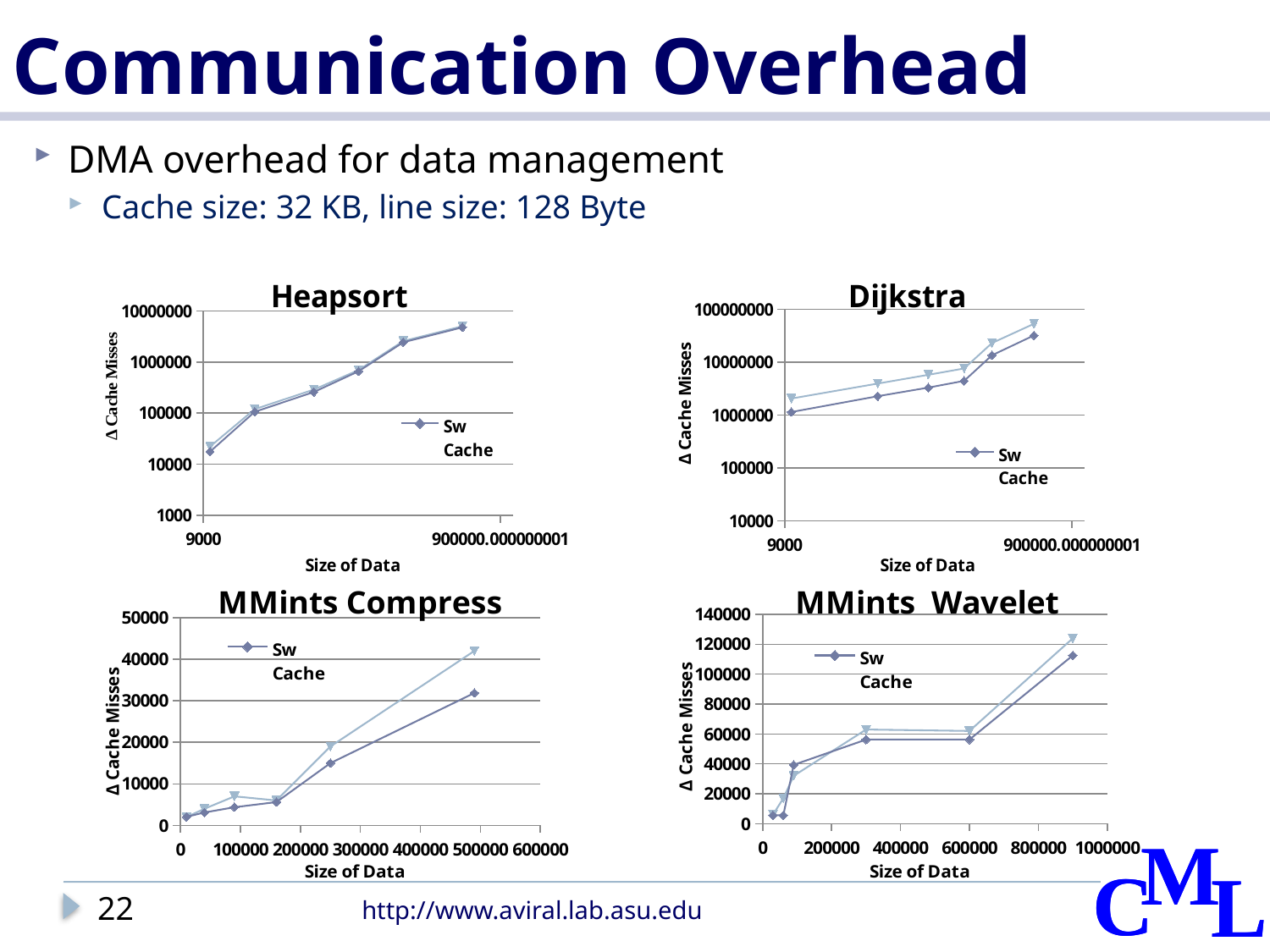
In the Dijkstra chart, is the value for Cache at the largest data size greater or less than 10000000? greater In the Heapsort chart, is the value for Sw at the smallest data size greater or less than 10000? greater In the Heapsort chart, do the cache misses rise or fall as the size of data increases? rise In the Dijkstra chart, do the values for the Cache series rise or fall along the x axis? rise In the MMints Wavelet chart, at the largest data size, which series is higher, Sw or Cache? Cache In the MMints Wavelet chart, is the value for Sw at the largest data size greater or less than 120000? less In the MMints Compress chart, at the largest data size, which series has the higher value, Sw or Cache? Cache What is the x-axis title of the MMints Wavelet chart? Size of Data How many series does the legend of the Dijkstra chart list? 2 What kind of chart is the Heapsort chart? line chart What are the two series named in the legend of the MMints Compress chart? Sw and Cache